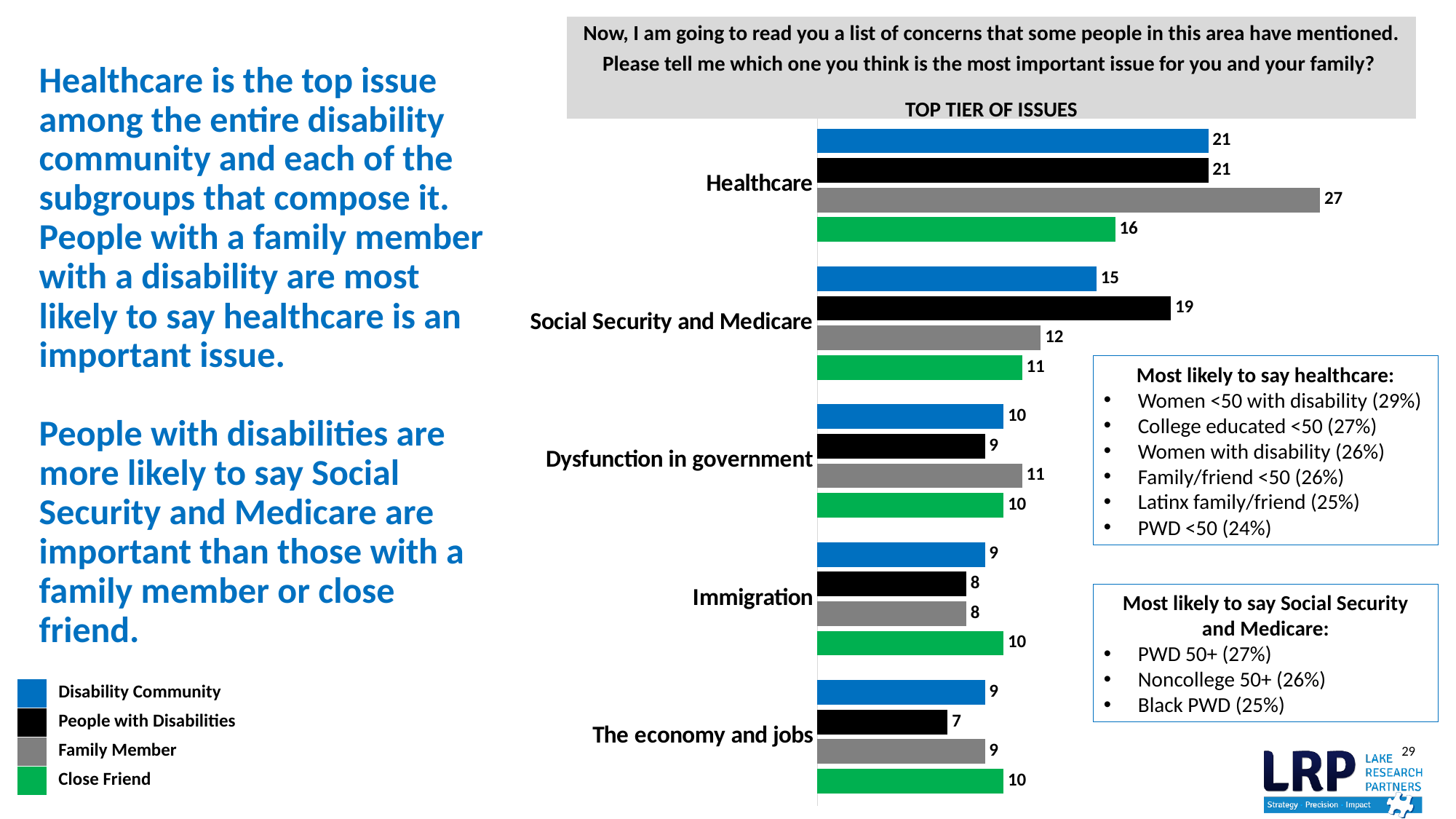
What is the title of the chart? TOP TIER OF ISSUES Which is larger on Social Security and Medicare: the Disability Community value or the People with Disabilities value? People with Disabilities What is the value for Family Member on Healthcare? 27 Which series has the lowest value on Healthcare? Close Friend What is the value for People with Disabilities on Social Security and Medicare? 19 How many series does the legend list? 4 What is the value for Disability Community on The economy and jobs? 9 How many issues are shown on the chart? 5 What is the value for Close Friend on Immigration? 10 Which issue has the highest value for the Disability Community series? Healthcare What is the difference between the Family Member and Close Friend values on Healthcare? 11 What kind of chart is shown on the slide? Bar chart